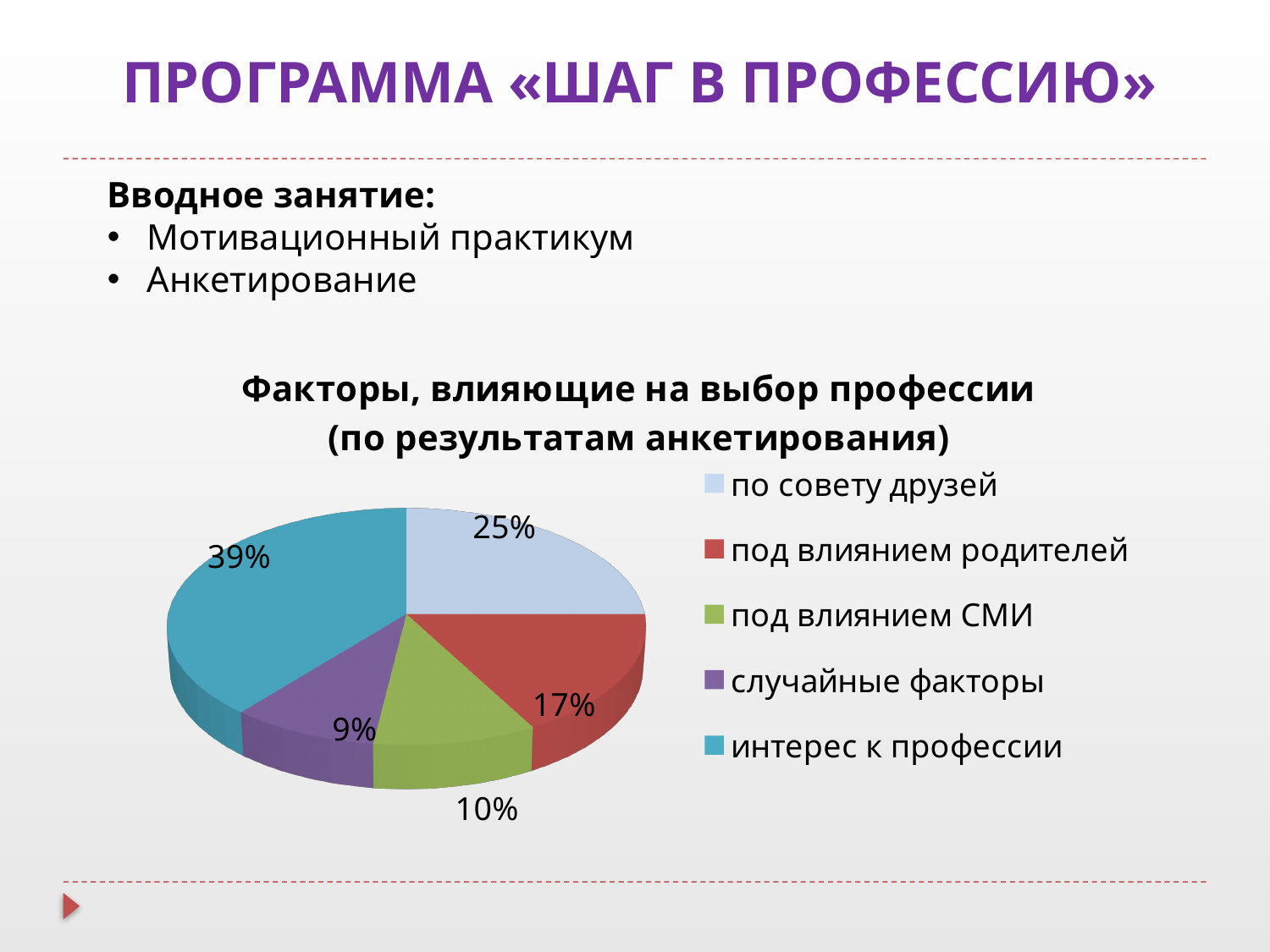
What is the title of the chart? Факторы, влияющие на выбор профессии (по результатам анкетирования) What is the value for "случайные факторы"? 9% What is the value for "под влиянием СМИ"? 10% How many slices does the pie chart have? 5 What is the value for "под влиянием родителей"? 17% Which is larger: the share for "под влиянием родителей" or for "под влиянием СМИ"? под влиянием родителей What is the difference between the shares for "интерес к профессии" and "по совету друзей"? 14% What share of the pie does "интерес к профессии" have? 39% Which factor has the largest share of the pie? интерес к профессии What share of the pie does "по совету друзей" have? 25% Which factor has the smallest share of the pie? случайные факторы What kind of chart is shown on the slide? pie chart